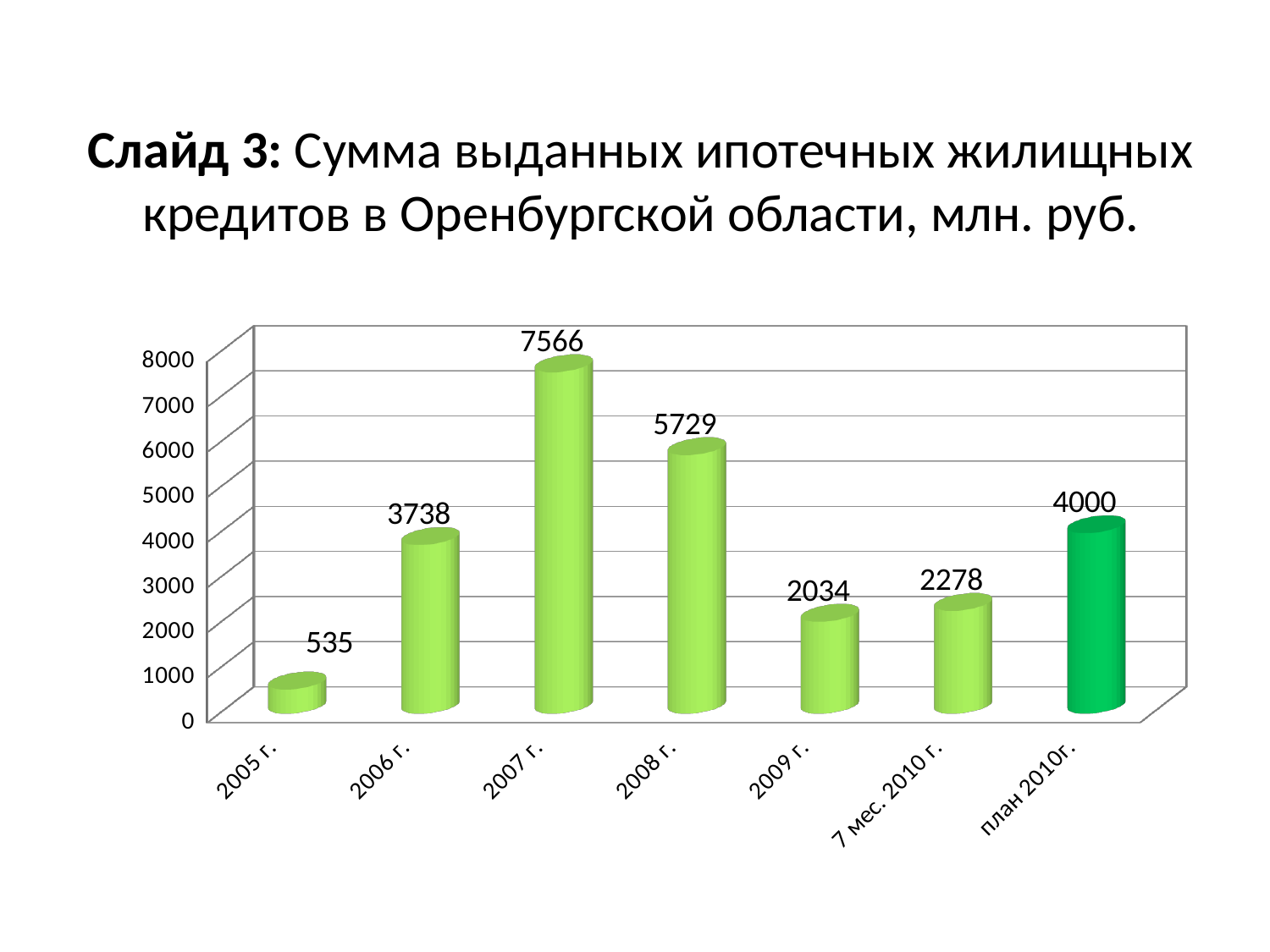
Which is larger, the value for 2006 г. or the value for 2009 г.? 2006 г. How many categories are shown on the x axis? 7 Which category has the highest value? 2007 г. Which category has the lowest value? 2005 г. What is the difference between the values for 2007 г. and 2008 г.? 1837 Which bar is shown in a darker green colour than the others? план 2010г. What is the value for 2005 г.? 535 What is the value for план 2010г.? 4000 What kind of chart is shown on the slide? bar chart What is the difference between the values for план 2010г. and 7 мес. 2010 г.? 1722 What is the value for 2007 г.? 7566 What is the value for 7 мес. 2010 г.? 2278